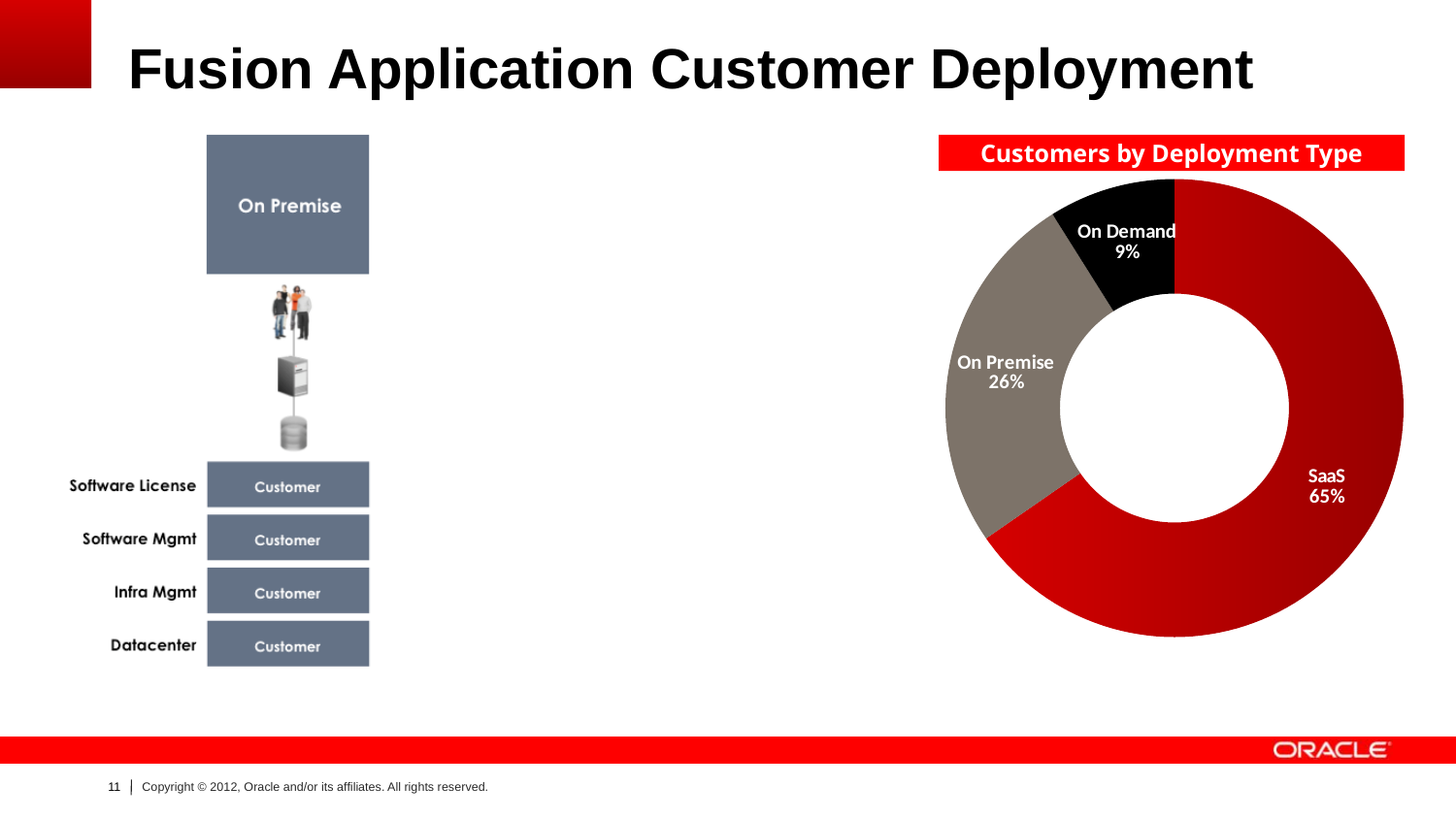
What kind of chart is the Customers by Deployment Type chart? Pie chart (doughnut) In the Customers by Deployment Type chart, what is the difference in percentage points between the On Premise and On Demand shares? 17 What share of customers does the SaaS slice represent in the Customers by Deployment Type chart? 65% Which deployment type has the largest share of customers in the Customers by Deployment Type chart? SaaS In the Customers by Deployment Type chart, which is larger: the On Premise share or the On Demand share? On Premise How many deployment types are shown in the Customers by Deployment Type chart? 3 What share of customers does the On Premise slice represent in the Customers by Deployment Type chart? 26% Which deployment type has the smallest share of customers in the Customers by Deployment Type chart? On Demand What share of customers does the On Demand slice represent in the Customers by Deployment Type chart? 9% What is the title of the chart on the right side of the slide? Customers by Deployment Type In the Customers by Deployment Type chart, what is the difference in percentage points between the SaaS and On Premise shares? 39 What colour is the SaaS slice in the Customers by Deployment Type chart? Red